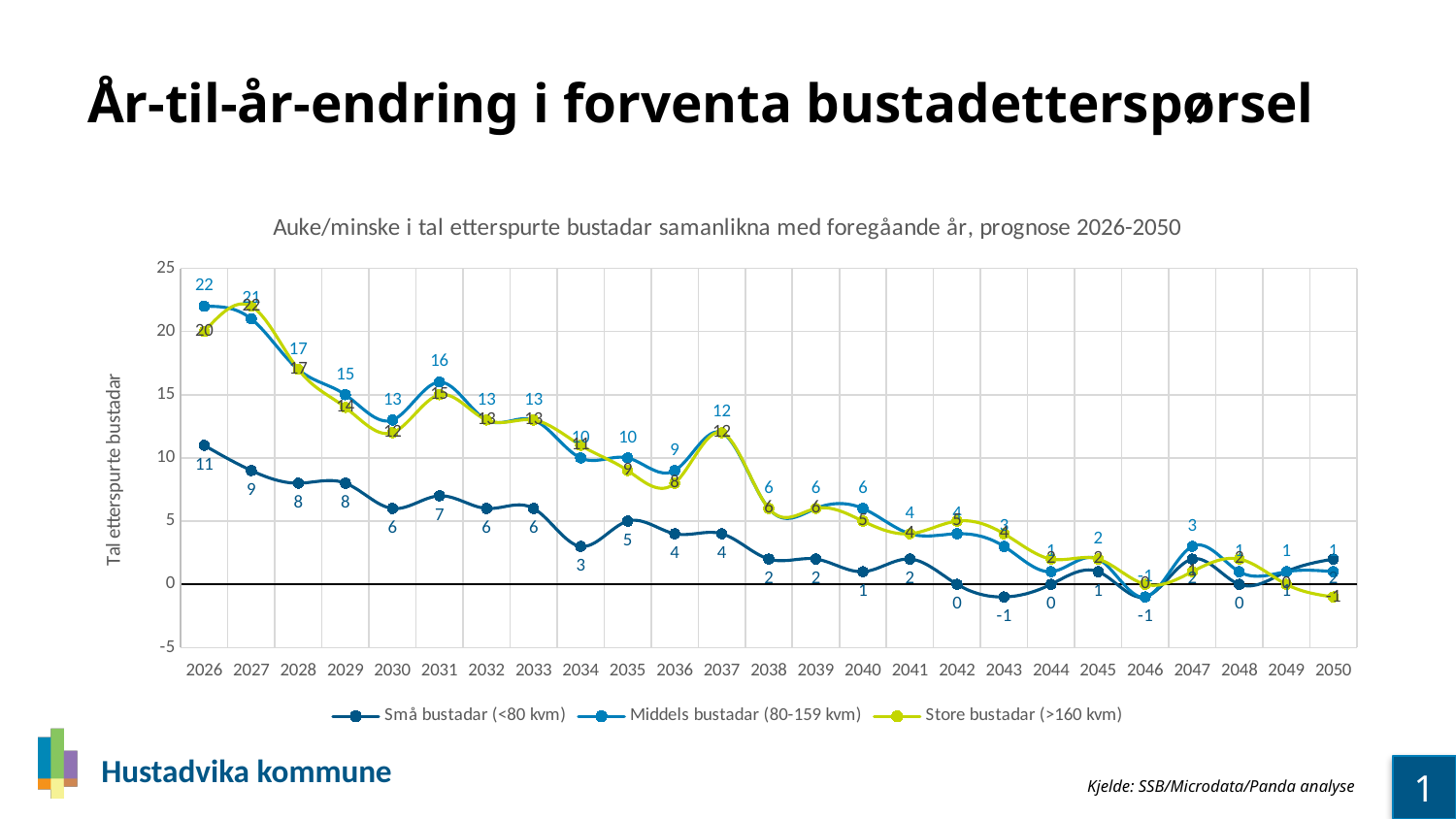
How many years are plotted along the x axis? 25 What is the difference between Middels bustadar (80-159 kvm) and Små bustadar (<80 kvm) in 2026? 11 In which year does Middels bustadar (80-159 kvm) reach its highest value? 2026 What is the value for Middels bustadar (80-159 kvm) in 2031? 16 In 2031, which is larger: Middels bustadar (80-159 kvm) or Små bustadar (<80 kvm)? Middels bustadar (80-159 kvm) What kind of chart is shown on the slide? line chart Do the values for Middels bustadar (80-159 kvm) generally rise or fall from 2026 to 2050? fall What is the value for Store bustadar (>160 kvm) in 2050? -1 How many series does the legend list? 3 What is the value for Små bustadar (<80 kvm) in 2043? -1 What is the value for Middels bustadar (80-159 kvm) in 2026? 22 What is the value for Små bustadar (<80 kvm) in 2026? 11